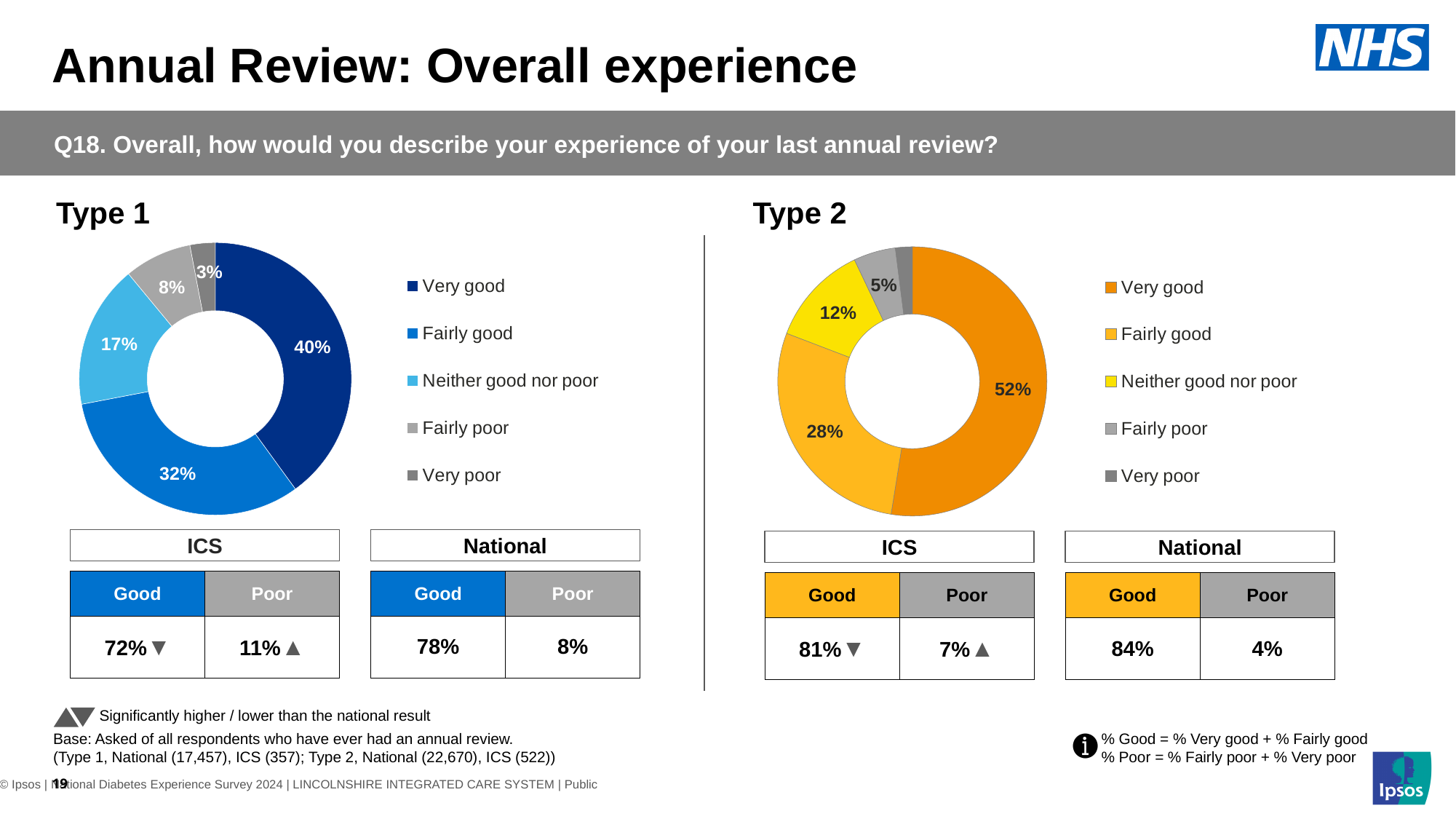
In the Type 2 chart, what percentage of respondents described their experience as Fairly good? 28% In the Type 1 chart, which category has the smallest share? Very poor In the Type 2 chart, which category has the largest share? Very good In the Type 2 chart, what is the difference between the Very good and Fairly good shares? 24% What kind of chart is used for Type 2? Donut chart In the Type 1 chart, what colour is the Very good segment? Dark blue In the Type 2 chart, what is the value for Fairly poor? 5% In the Type 1 chart, what is the difference between the Very good and Fairly good shares? 8% In the Type 1 chart, what is the value for Neither good nor poor? 17% How many series does the legend of the Type 1 chart list? 5 In the Type 1 chart, what percentage of respondents described their experience as Very good? 40% Which is larger: the Very good share in the Type 1 chart or the Very good share in the Type 2 chart? Type 2